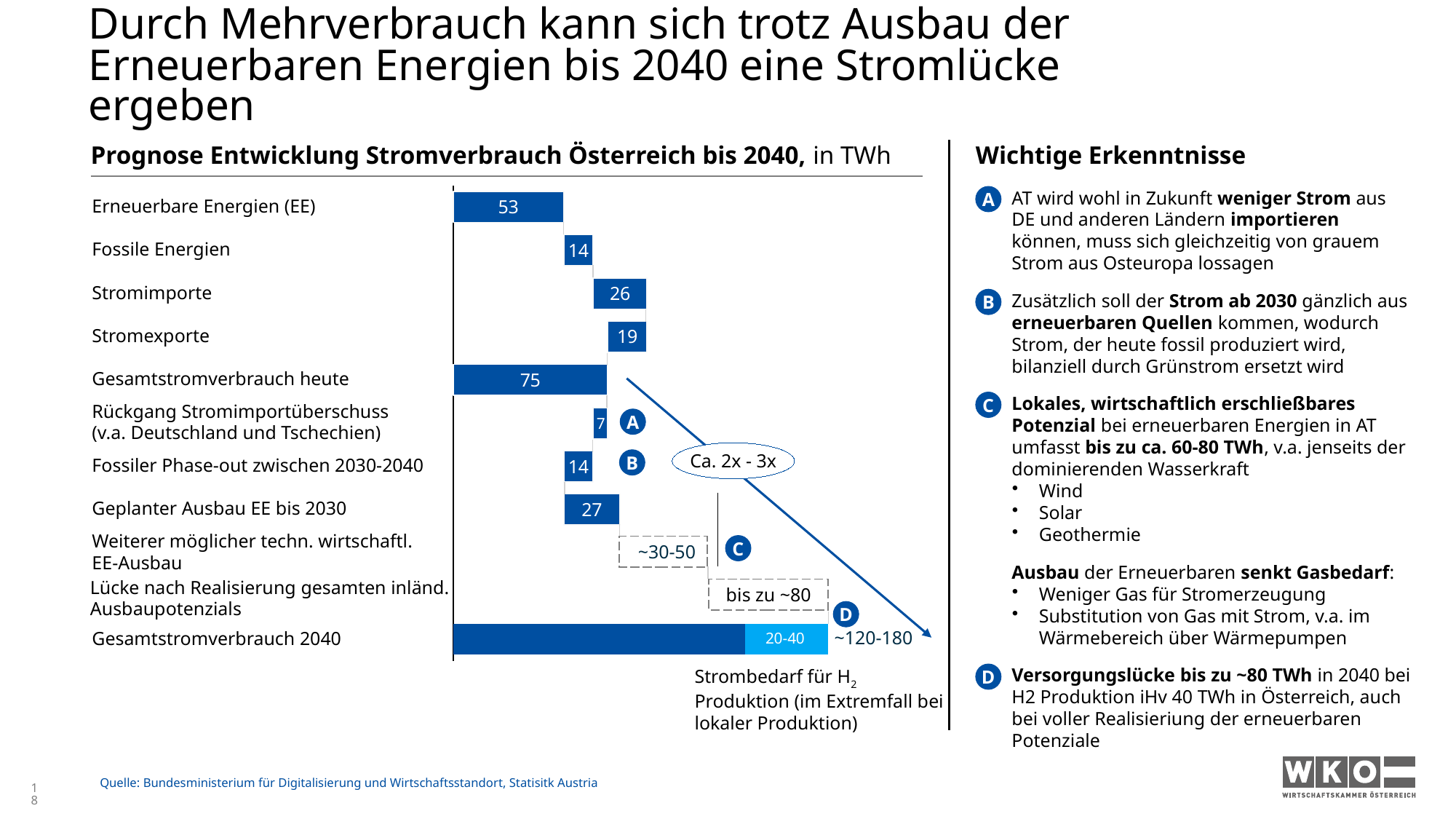
What range is shown for Weiterer möglicher techn. wirtschaftl. EE-Ausbau? ~30-50 What unit are the values in the chart expressed in? TWh What is the value shown for Geplanter Ausbau EE bis 2030? 27 What total is labelled next to the Gesamtstromverbrauch 2040 bar? ~120-180 What is the difference between Gesamtstromverbrauch heute and Erneuerbare Energien (EE)? 22 What is the value shown for Stromimporte? 26 Which is larger, Stromimporte or Stromexporte? Stromimporte What kind of chart is shown on the slide? Bar chart (waterfall) Which category has the largest exactly labelled value in the chart? Gesamtstromverbrauch heute What is the value shown for Erneuerbare Energien (EE)? 53 What is the value shown for Gesamtstromverbrauch heute? 75 What value is labelled for Rückgang Stromimportüberschuss (v.a. Deutschland und Tschechien)? 7